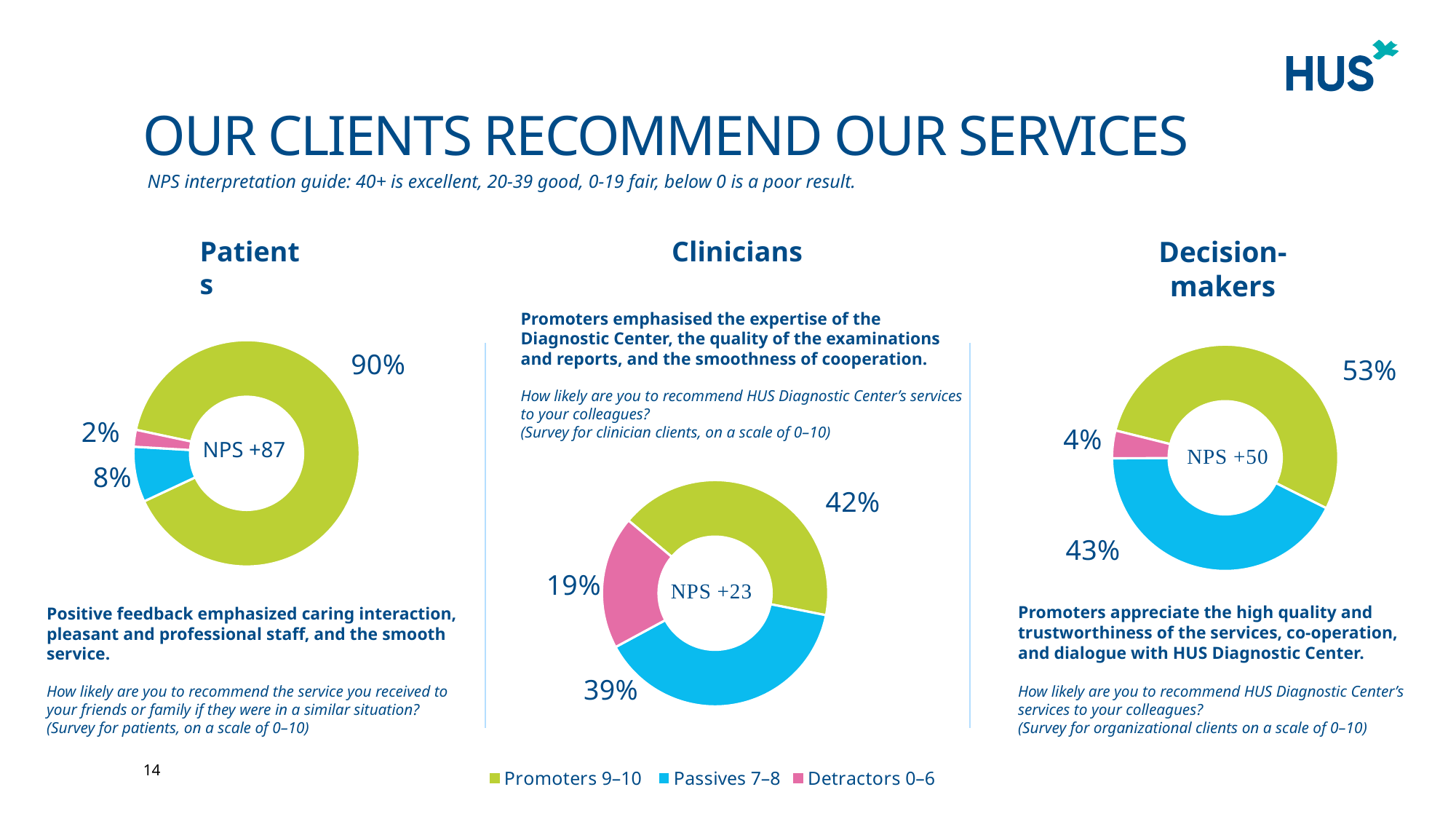
In the Clinicians chart, what percentage are Passives 7–8? 39% In the Decision-makers chart, which group has the largest share? Promoters 9–10 What NPS value is shown in the centre of the Clinicians chart? NPS +23 In the Patients chart, what is the difference between the Promoters 9–10 share and the Passives 7–8 share? 82% In the Clinicians chart, which group has the smallest share? Detractors 0–6 In the Patients chart, what percentage are Promoters 9–10? 90% In the Patients chart, what percentage are Detractors 0–6? 2% How many series does the legend list for the charts? 3 Which colour represents Detractors 0–6 in the legend? Pink In the Decision-makers chart, what percentage are Promoters 9–10? 53% Which is larger in the Clinicians chart: the Promoters 9–10 share or the Passives 7–8 share? Promoters 9–10 What type of chart is used for the Patients, Clinicians and Decision-makers data? Doughnut chart